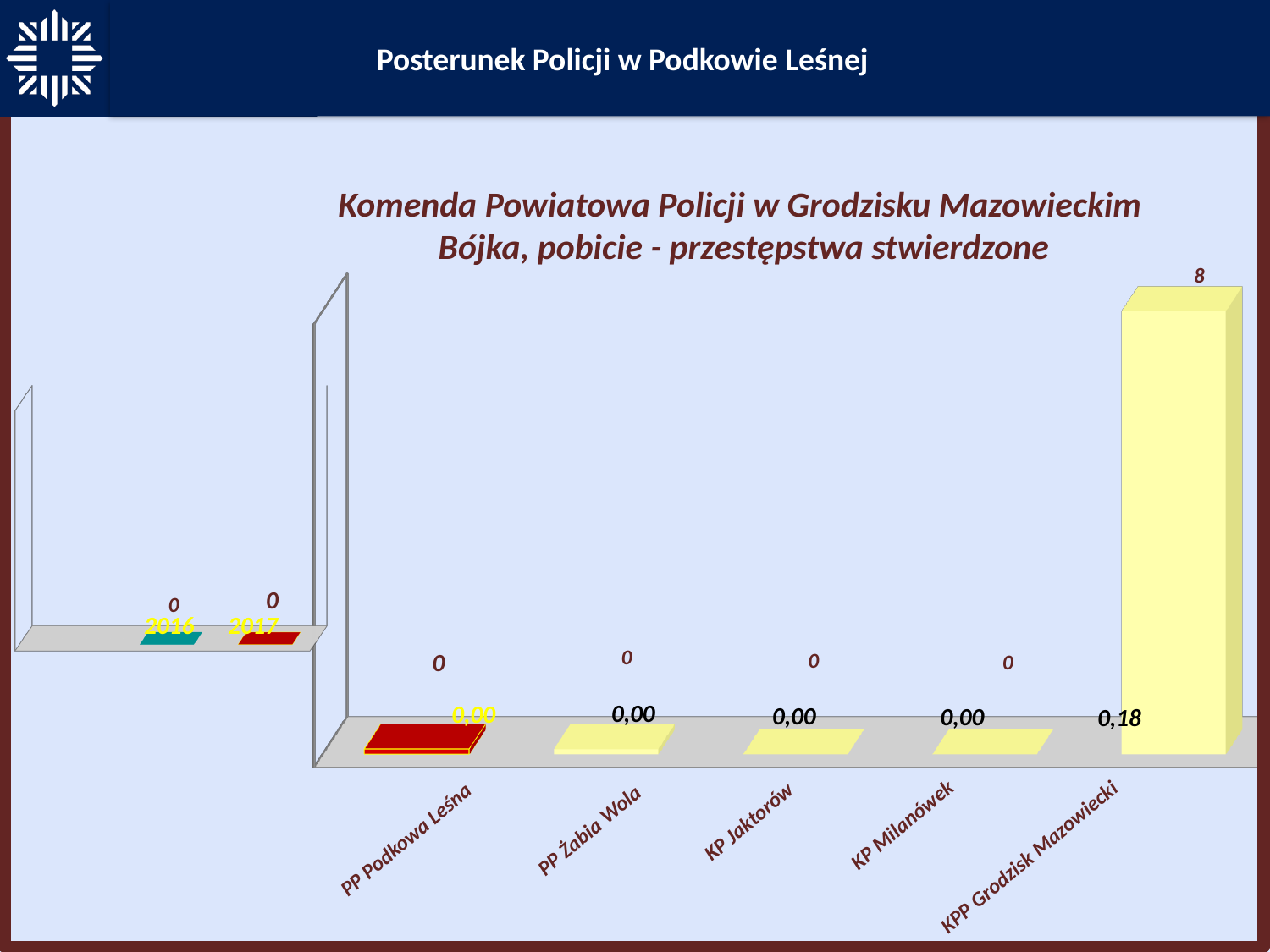
In the right-hand chart, how many categories are shown on the x axis? 5 In the right-hand chart, what is the difference between the value for KPP Grodzisk Mazowiecki and the value for KP Milanówek? 8 In the right-hand chart, which is larger: the value for KPP Grodzisk Mazowiecki or the value for PP Żabia Wola? KPP Grodzisk Mazowiecki In the small chart on the left, what is the value for 2016? 0 What is the second line of the title of the right-hand chart? Bójka, pobicie - przestępstwa stwierdzone In the right-hand chart, what is the second label shown at the base of the KPP Grodzisk Mazowiecki bar? 0,18 What type of chart is the right-hand chart? bar chart In the small chart on the left, what is the value for 2017? 0 In the right-hand chart, what is the value labelled above the bar for KP Jaktorów? 0 In the right-hand chart, what is the value labelled above the bar for KPP Grodzisk Mazowiecki? 8 In the right-hand chart, what is the value labelled above the bar for PP Podkowa Leśna? 0 In the right-hand chart, which category has the highest value? KPP Grodzisk Mazowiecki